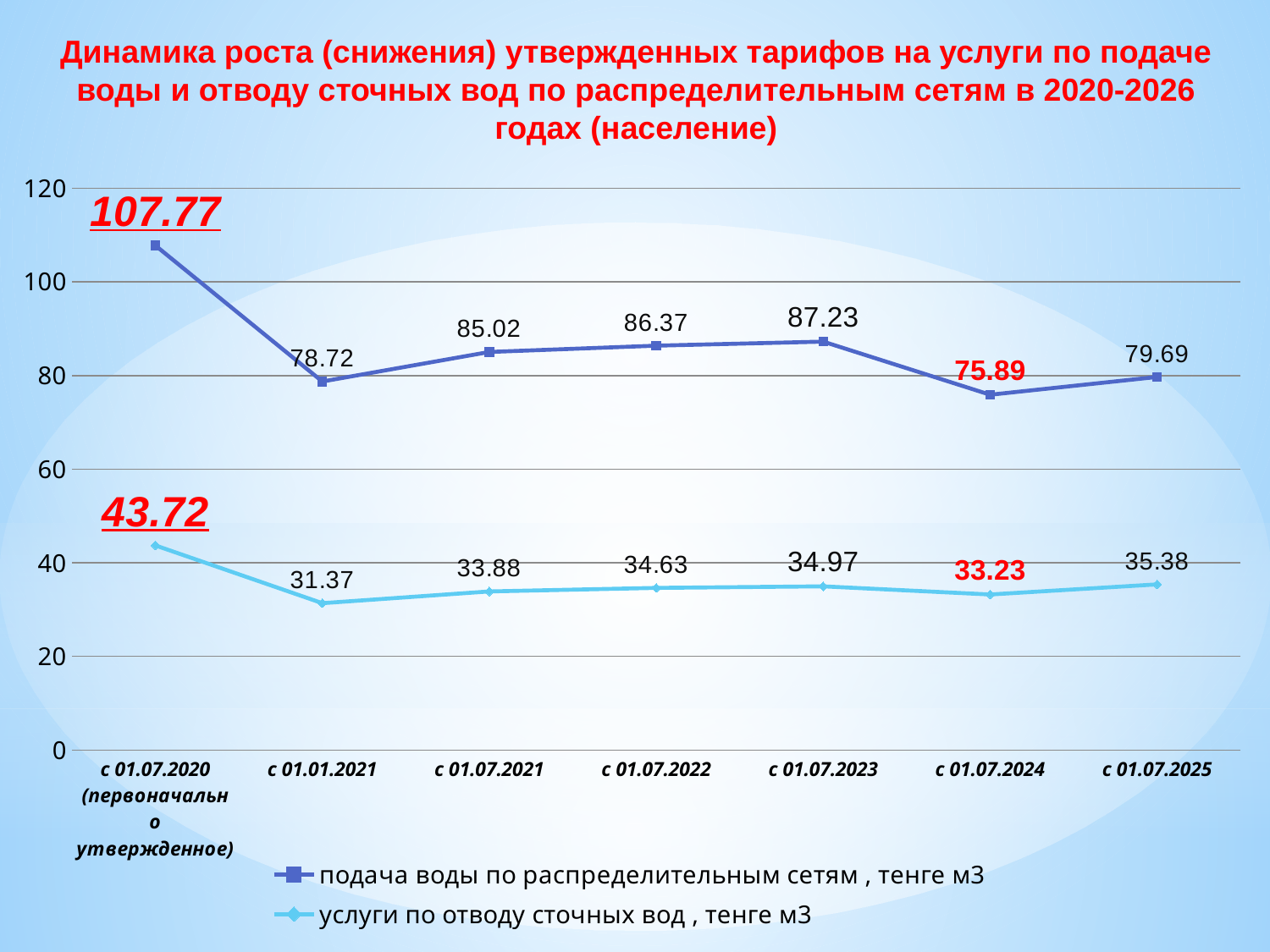
At which date is the value of 'услуги по отводу сточных вод , тенге м3' highest? с 01.07.2020 (первоначально утвержденное) Is the value of 'подача воды по распределительным сетям , тенге м3' at 'с 01.07.2020 (первоначально утвержденное)' greater or less than 100? greater What type of chart is shown on the slide? line chart What is the value of 'услуги по отводу сточных вод , тенге м3' at 'с 01.07.2024'? 33.23 At which date is the value of 'подача воды по распределительным сетям , тенге м3' lowest? с 01.07.2024 Does the value of 'подача воды по распределительным сетям , тенге м3' rise or fall from 'с 01.01.2021' to 'с 01.07.2023'? rise What is the value of 'подача воды по распределительным сетям , тенге м3' at 'с 01.07.2023'? 87.23 What is the difference between the 'подача воды по распределительным сетям , тенге м3' values at 'с 01.07.2020 (первоначально утвержденное)' and 'с 01.01.2021'? 29.05 Which is larger: the 'услуги по отводу сточных вод , тенге м3' value at 'с 01.07.2025' or at 'с 01.07.2024'? с 01.07.2025 How many data points are plotted for the series 'подача воды по распределительным сетям , тенге м3'? 7 What is the value of 'подача воды по распределительным сетям , тенге м3' at 'с 01.07.2020 (первоначально утвержденное)'? 107.77 How many series does the legend list? 2